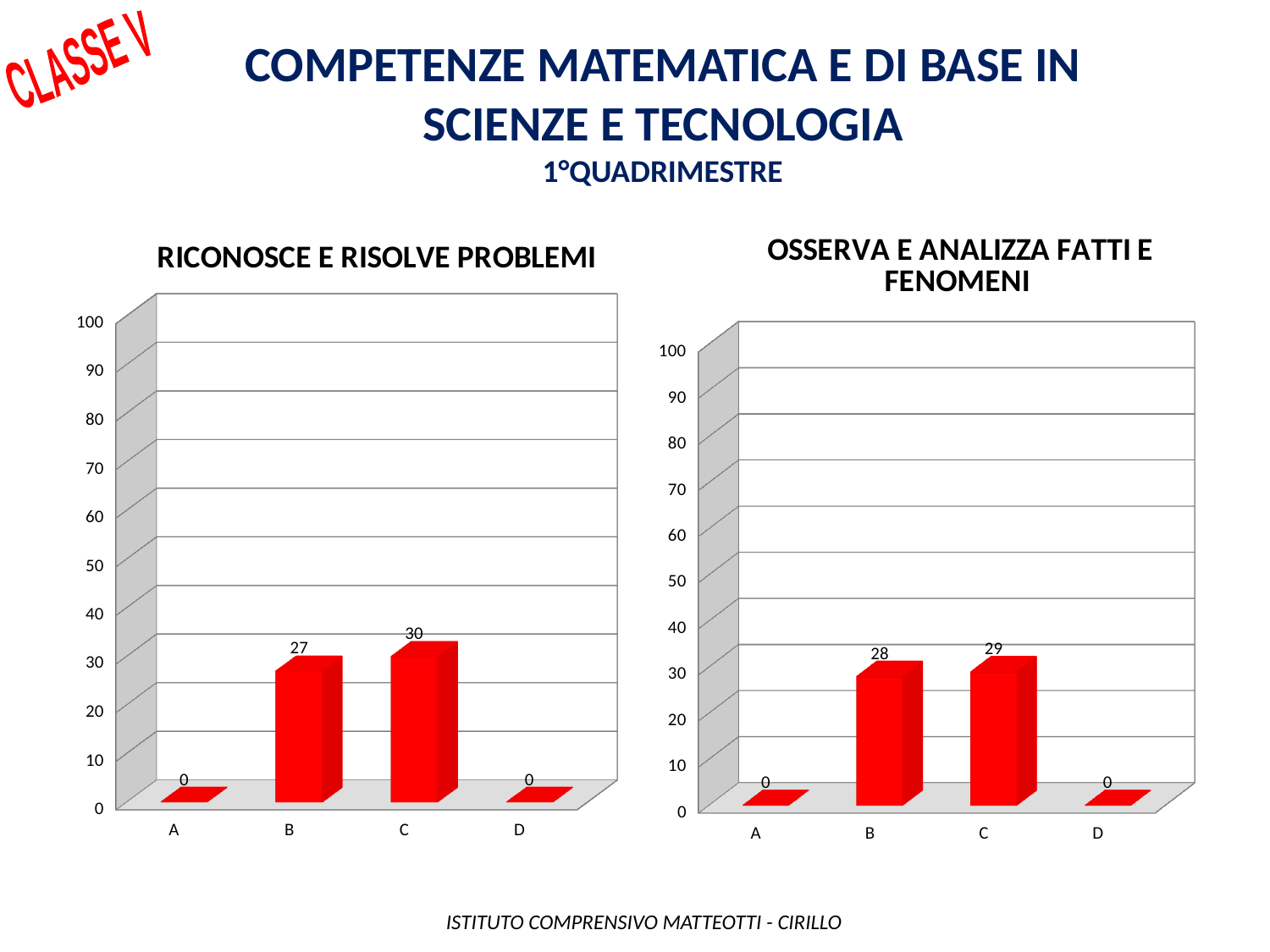
In the 'RICONOSCE E RISOLVE PROBLEMI' chart, is the value for B greater or less than 20? greater What is the title of the chart on the right side of the slide? OSSERVA E ANALIZZA FATTI E FENOMENI In the 'RICONOSCE E RISOLVE PROBLEMI' chart, what is the value for category B? 27 How many categories are shown in the 'OSSERVA E ANALIZZA FATTI E FENOMENI' chart? 4 In the 'RICONOSCE E RISOLVE PROBLEMI' chart, which category has the highest value? C In the 'OSSERVA E ANALIZZA FATTI E FENOMENI' chart, what is the value for category B? 28 In the 'OSSERVA E ANALIZZA FATTI E FENOMENI' chart, what is the difference between the values for C and B? 1 In the 'RICONOSCE E RISOLVE PROBLEMI' chart, what is the value for category C? 30 What kind of chart is the 'RICONOSCE E RISOLVE PROBLEMI' chart? Bar chart In the 'OSSERVA E ANALIZZA FATTI E FENOMENI' chart, which category has the highest value? C In the 'OSSERVA E ANALIZZA FATTI E FENOMENI' chart, what is the value for category D? 0 In the 'RICONOSCE E RISOLVE PROBLEMI' chart, what is the difference between the values for C and B? 3